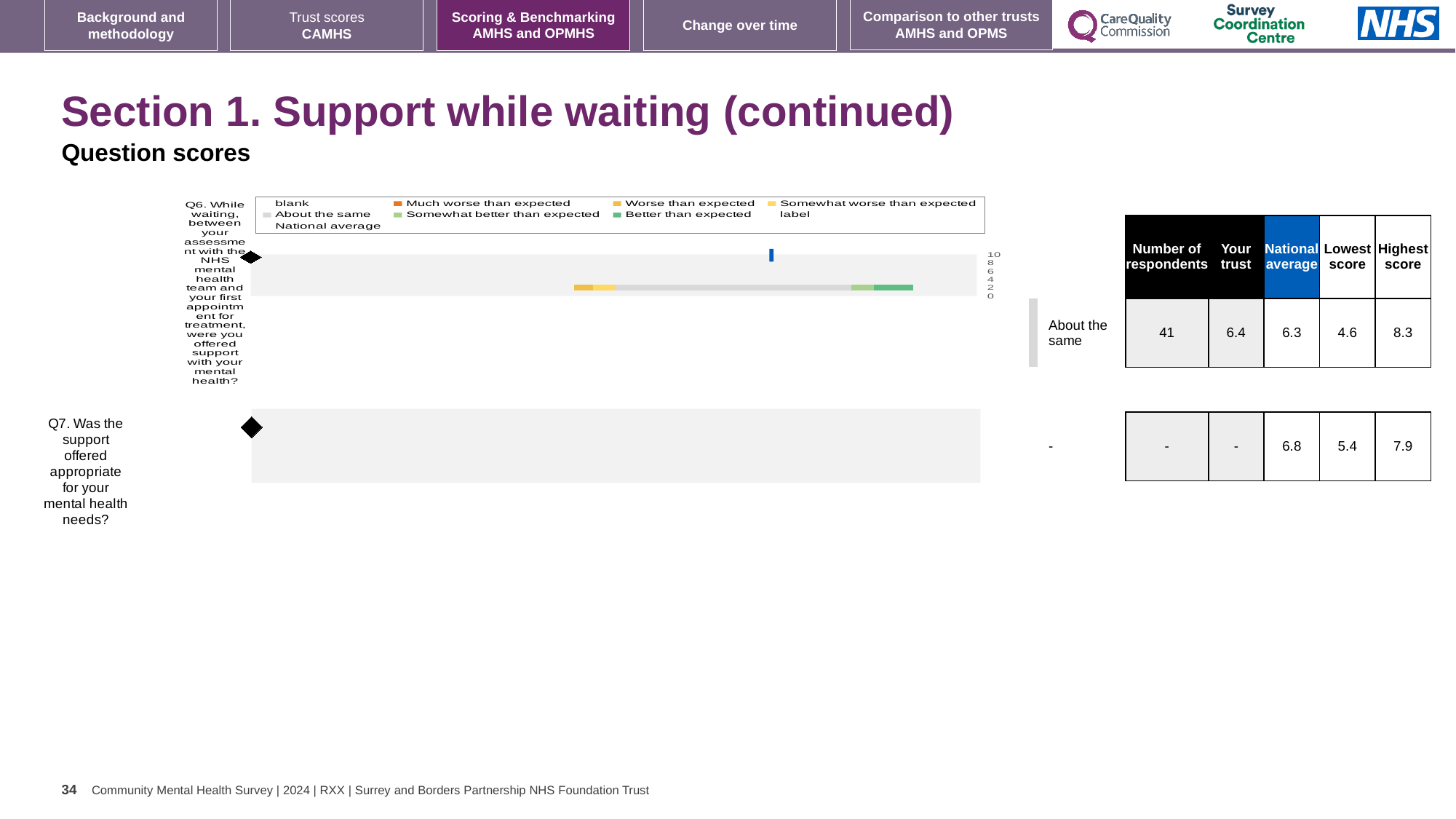
How many questions (Q6 and Q7) are listed as categories on the chart? 2 According to the table, what is the highest score for Q6? 8.3 According to the table, what is the national average score for Q7? 6.8 According to the table next to the chart, what is the 'Your trust' score for Q6? 6.4 According to the table next to the chart, what is the national average score for Q6? 6.3 What kind of chart is used to show the question scores on this slide? bar chart What is the difference between the highest score and the lowest score for Q6 in the table? 3.7 According to the table, what is the lowest score for Q7? 5.4 According to the table, how many respondents answered Q6? 41 For Q6, which is larger: the 'Your trust' score or the national average? Your trust What is the highest value shown on the chart's axis? 10